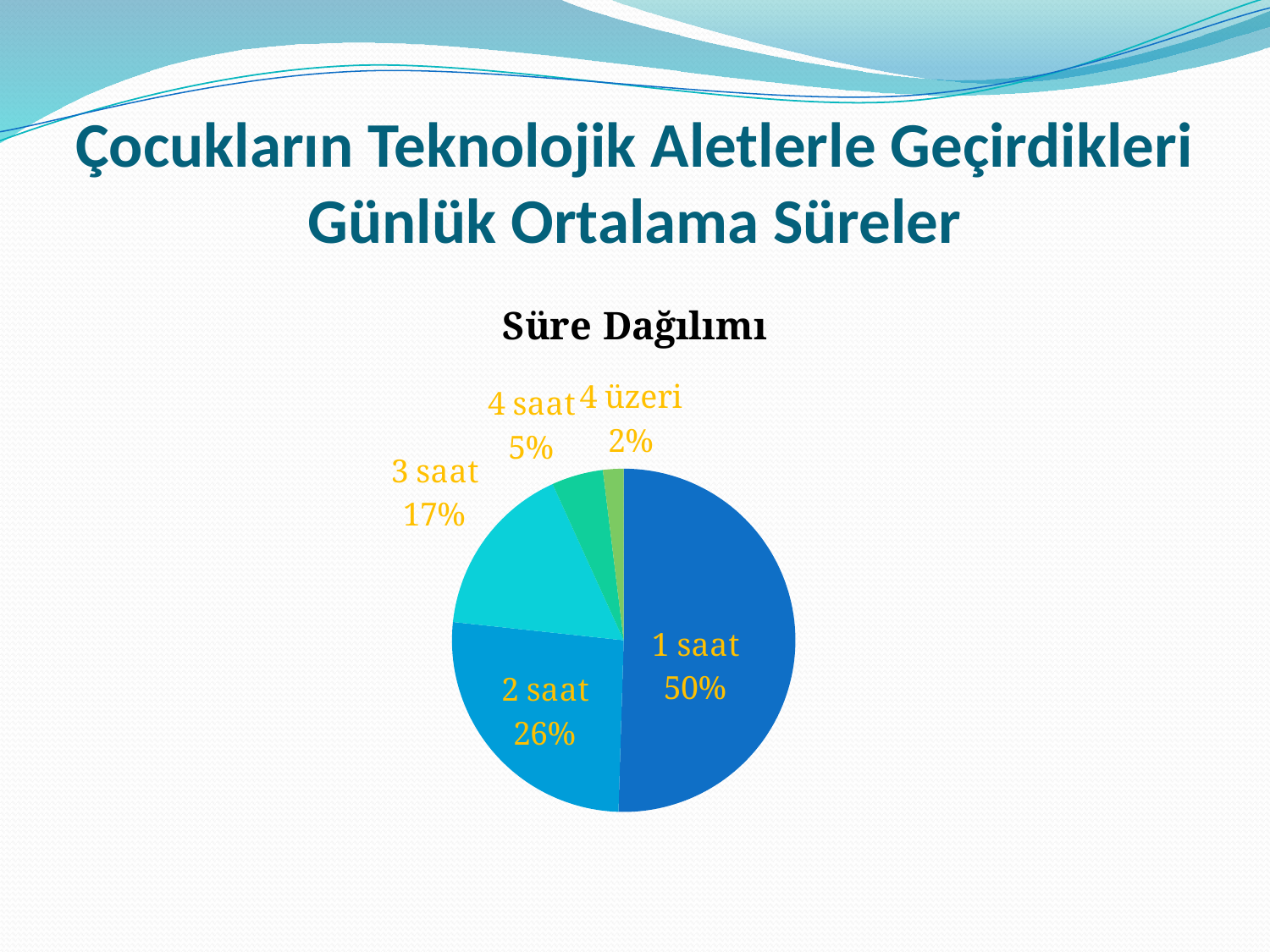
What is the difference between the shares for "1 saat" and "2 saat"? 24% What kind of chart is shown on the slide? pie chart What is the value shown for "4 üzeri"? 2% What share of the pie does the "1 saat" slice represent? 50% What is the chart's title? Süre Dağılımı Which category has the smallest share of the pie? 4 üzeri What is the value shown for "2 saat"? 26% How many slices does the pie chart have? 5 Which category has the largest share of the pie? 1 saat What is the value shown for "4 saat"? 5% Which is larger, the share for "3 saat" or the share for "4 saat"? 3 saat What is the value shown for "3 saat"? 17%